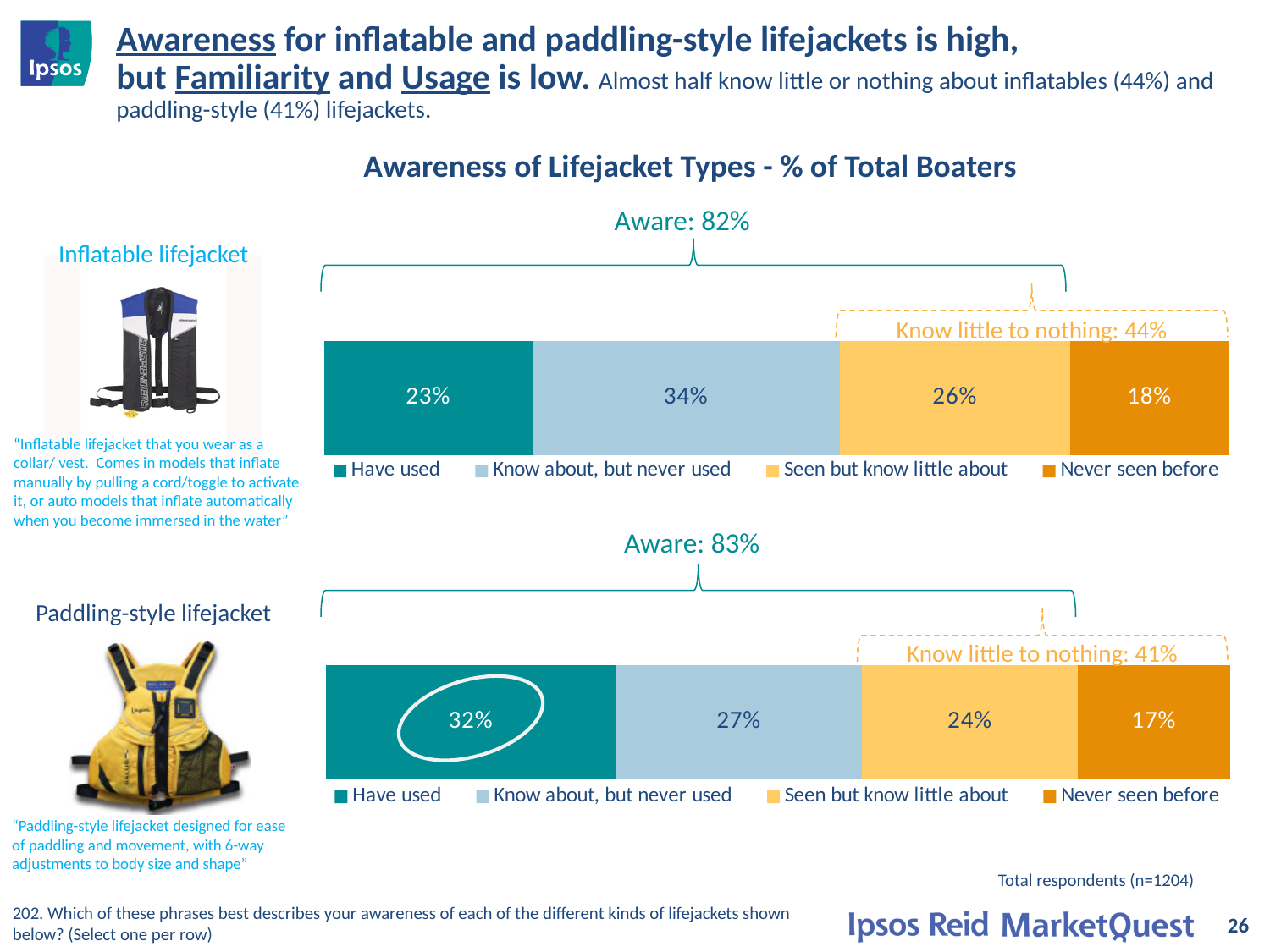
In the Inflatable lifejacket chart, which response category has the highest percentage? Know about, but never used In the Paddling-style lifejacket chart, which response category has the lowest percentage? Never seen before Which is larger: the 'Seen but know little about' share for inflatable lifejackets or for paddling-style lifejackets? Inflatable lifejackets In the Paddling-style lifejacket chart, what is the 'Know little to nothing' percentage shown above the bar? 41% In the Inflatable lifejacket chart, what percentage of boaters have used an inflatable lifejacket? 23% What is the difference between the 'Have used' percentage for paddling-style lifejackets and for inflatable lifejackets? 9 percentage points What type of chart is used to show awareness of lifejacket types? Stacked bar chart In the Paddling-style lifejacket chart, what percentage of boaters have never seen a paddling-style lifejacket before? 17% In the Paddling-style lifejacket chart, what percentage of boaters have used a paddling-style lifejacket? 32% How many series does the legend list for each chart? 4 In the Inflatable lifejacket chart, what is the combined 'Aware' percentage shown above the bar? 82% In the Inflatable lifejacket chart, what percentage of boaters know about but have never used an inflatable lifejacket? 34%